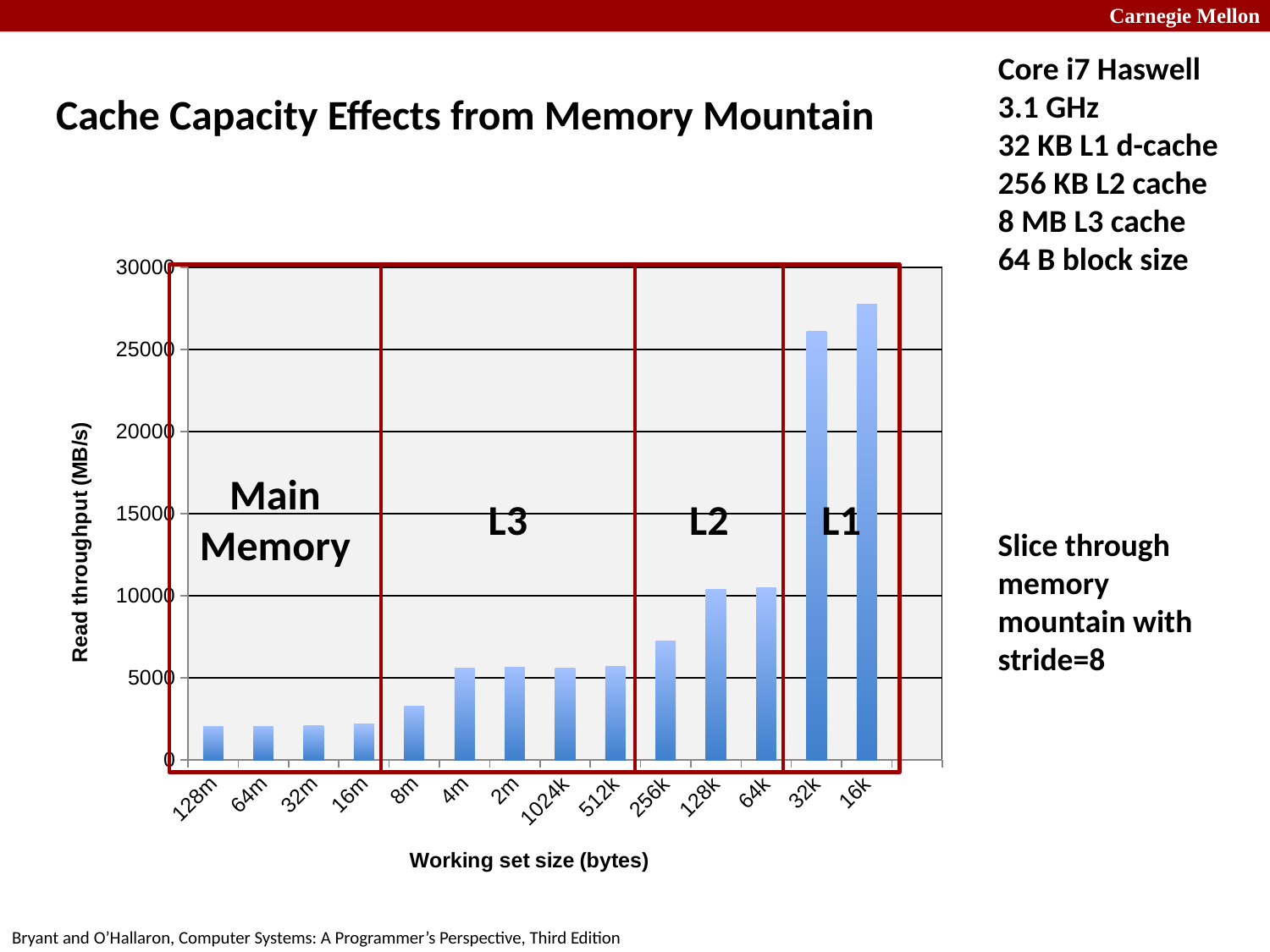
Which cache region label is placed over the two rightmost bars (32k and 16k)? L1 Is the read throughput for a working set size of 256k greater or less than 10000 MB/s? less How many working set sizes are plotted on the x axis? 14 Which working set size has the highest read throughput? 16k Is the read throughput for a working set size of 16k greater or less than 25000 MB/s? greater Which has the higher read throughput, a working set size of 8m or 16m? 8m What kind of chart is shown on the slide? bar chart Is the read throughput for a working set size of 8m greater or less than 5000 MB/s? less What is the label of the y axis? Read throughput (MB/s) Do the read throughput values generally rise or fall moving from left to right along the x axis? rise Which has the higher read throughput, a working set size of 256k or 512k? 256k